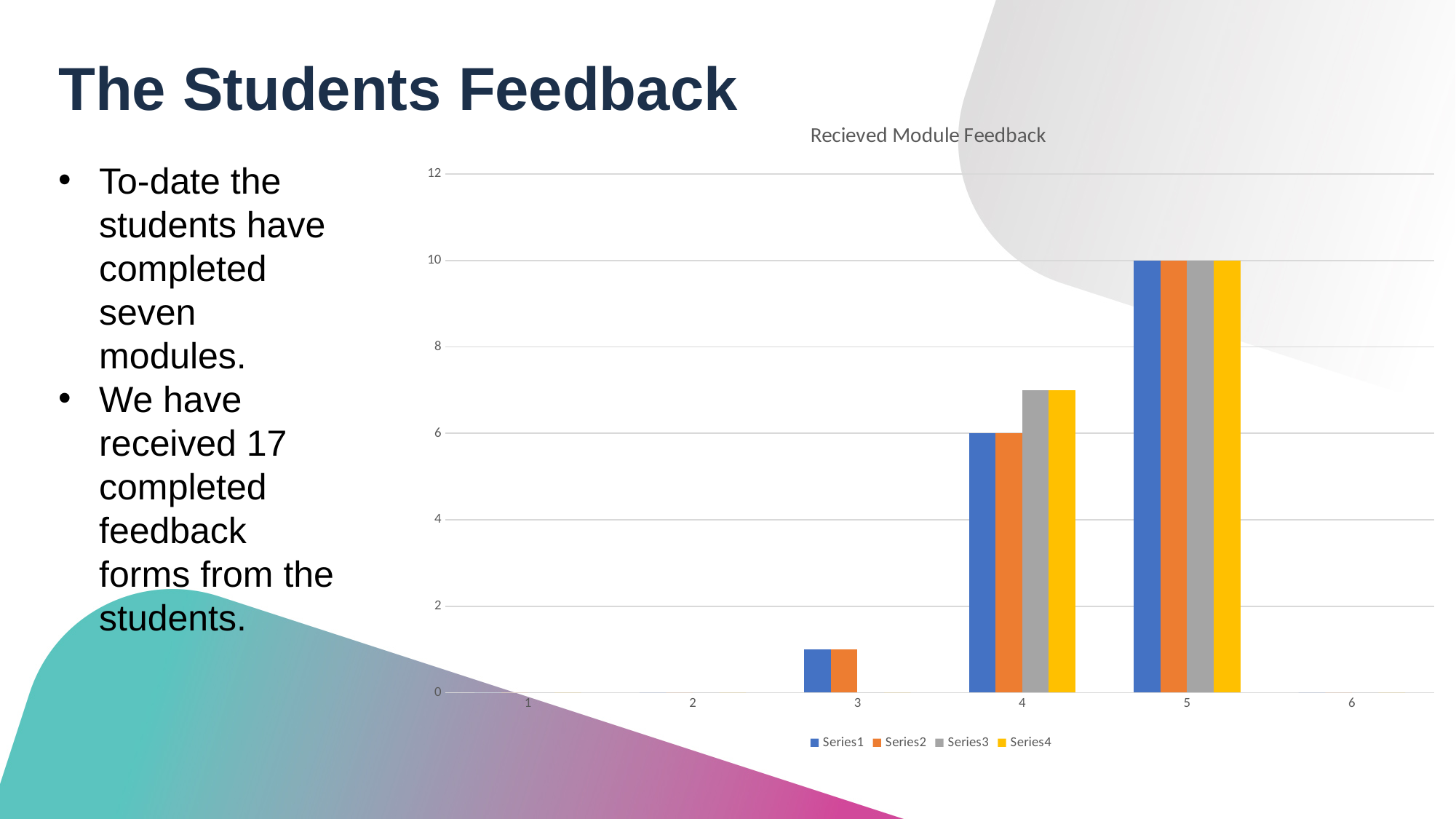
What kind of chart is shown on the slide? bar chart What is the value of Series1 for category 5? 10 What is the difference between the Series1 values for category 5 and category 4? 4 What is the value of Series2 for category 4? 6 How many series does the legend list? 4 Is the value of Series1 for category 3 greater or less than 2? less Is the value of Series3 for category 4 greater or less than 6? greater What is the title of the chart? Recieved Module Feedback What is the value of Series1 for category 4? 6 Which category has the highest value for Series1? 5 How many categories are shown on the x axis? 6 Do the Series1 values rise or fall from category 3 to category 5? rise